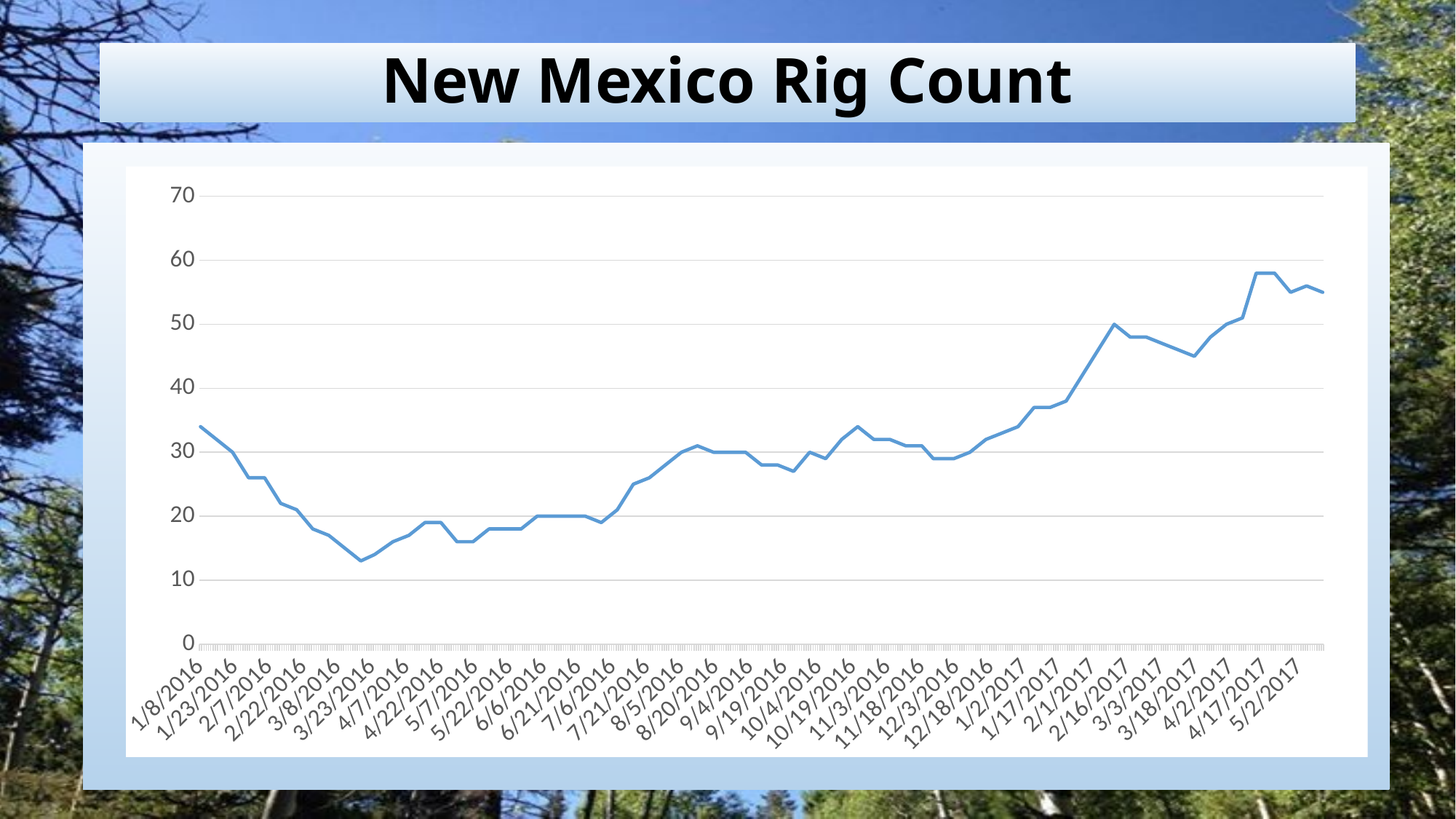
What is the highest value shown on the vertical axis? 70 Is the value at 4/17/2017 greater or less than 50? greater What kind of chart is shown on the slide? line chart Is the value at 3/23/2016 greater or less than 20? less What is the title of the chart? New Mexico Rig Count Does the line rise or fall between 1/8/2016 and 3/23/2016? fall Overall, does the rig count rise or fall from the start of the chart to the end? rise Is the value at 3/3/2017 greater or less than 40? greater